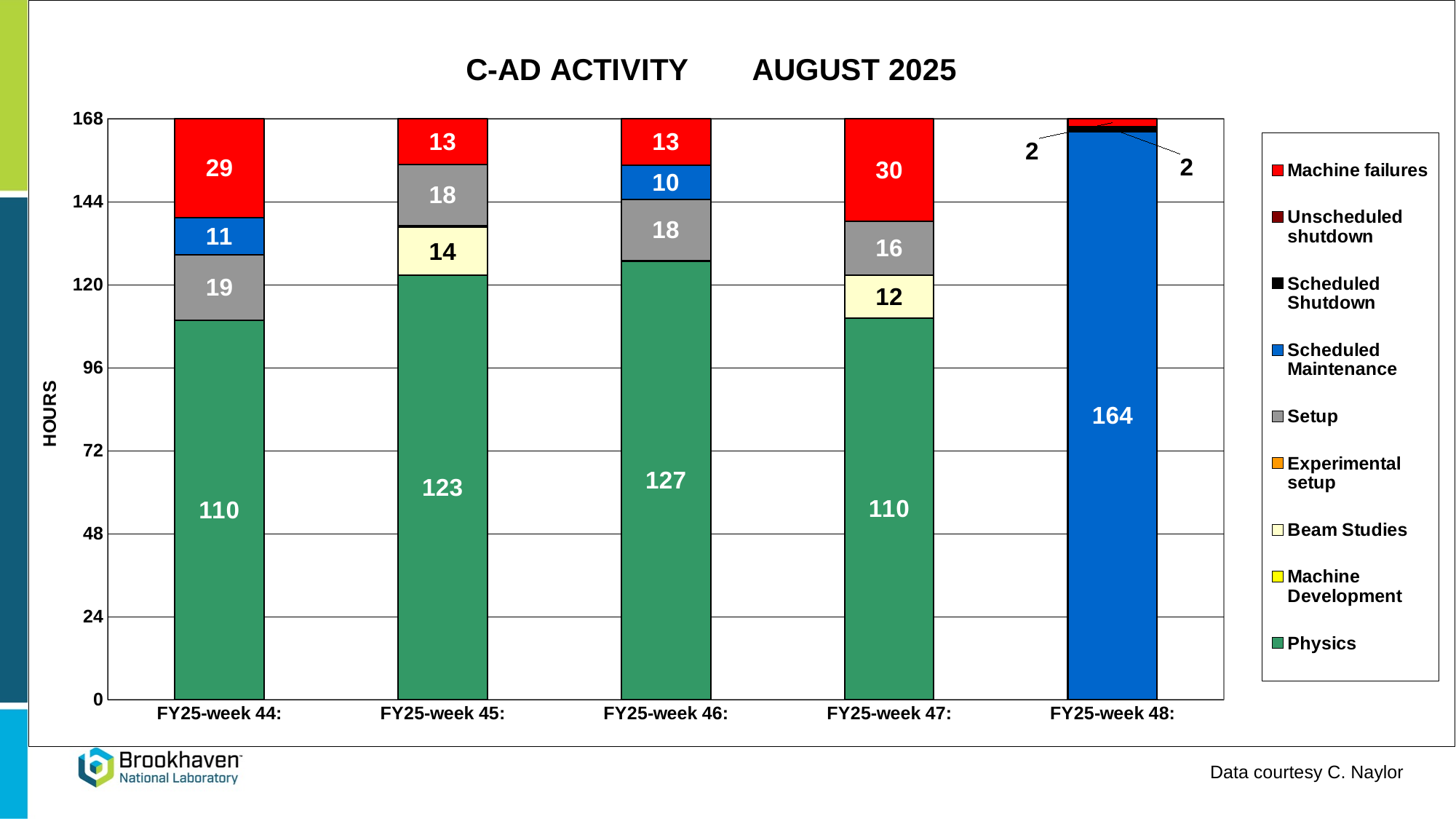
How many Beam Studies hours are shown for FY25-week 45? 14 What is the difference in Physics hours between FY25-week 46 and FY25-week 44? 17 Which week has the lowest number of Machine failures hours? FY25-week 48 Which week has more Setup hours, FY25-week 44 or FY25-week 47? FY25-week 44 How many Physics hours are shown for FY25-week 46? 127 Which week has the highest number of Physics hours? FY25-week 46 How many weeks are shown on the x axis? 5 How many Machine failures hours are shown for FY25-week 47? 30 How many Scheduled Maintenance hours are shown for FY25-week 48? 164 What is the total number of hours in the FY25-week 45 bar? 168 How many series does the legend list? 9 What kind of chart is shown on the slide? Stacked bar chart